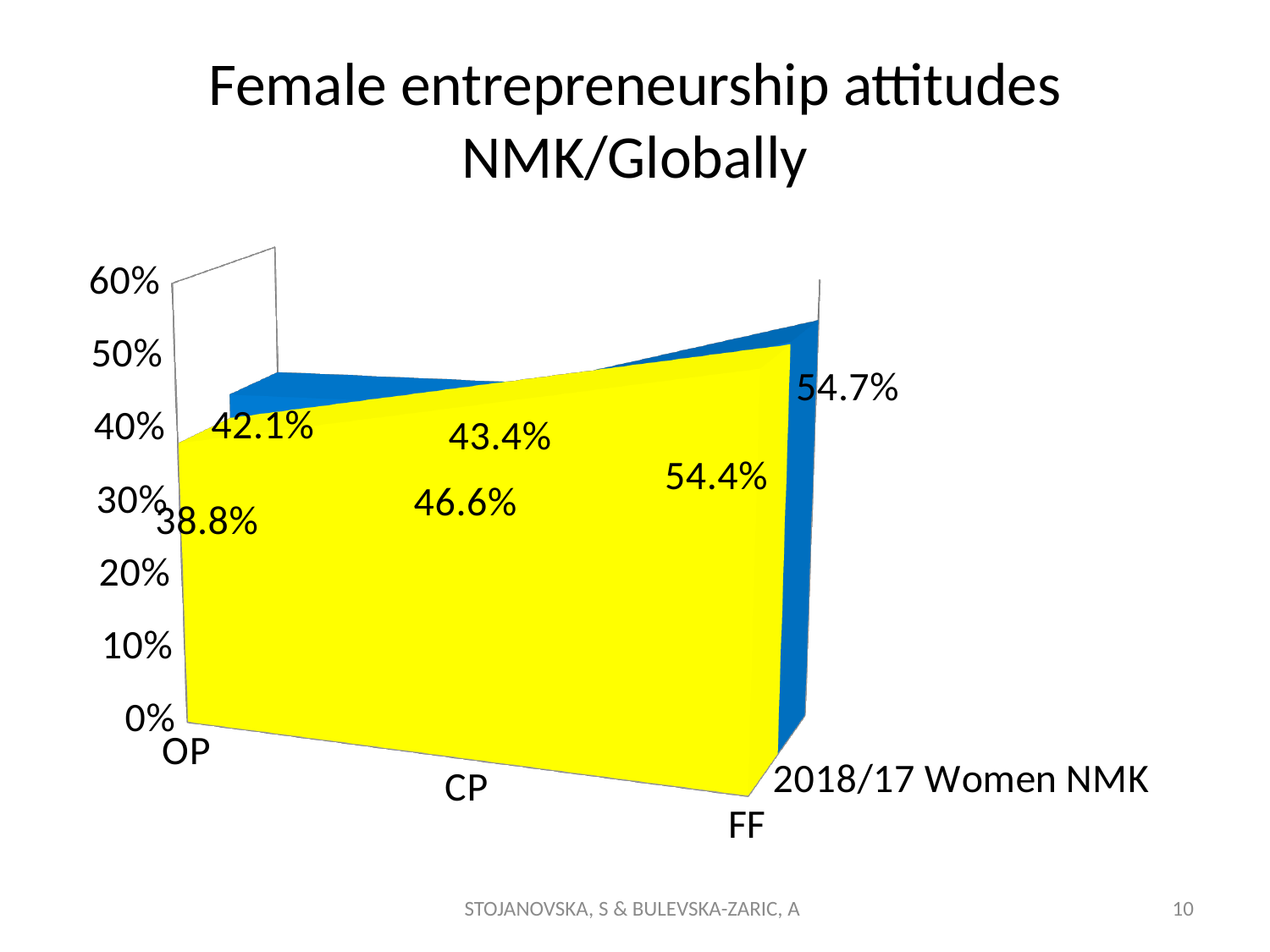
What is the value for OP in the 2018/17 Women NMK series? 38.8% Is the 2018/17 Women NMK value for OP greater or less than 40%? less Which category has the lowest value in the 2018/17 Women NMK series? OP In the 2018/17 Women NMK series, which is larger: the value for CP or the value for OP? CP What is the value for CP in the 2018/17 Women NMK series? 46.6% In the 2018/17 Women NMK series, what is the difference between the FF value and the OP value? 15.6 percentage points What is the title of the chart slide? Female entrepreneurship attitudes NMK/Globally Do the 2018/17 Women NMK values rise or fall from OP to FF? rise Is the 2018/17 Women NMK value for FF greater or less than 50%? greater What is the value for FF in the 2018/17 Women NMK series? 54.4% Which category has the highest value in the 2018/17 Women NMK series? FF How many categories are shown on the x axis? 3